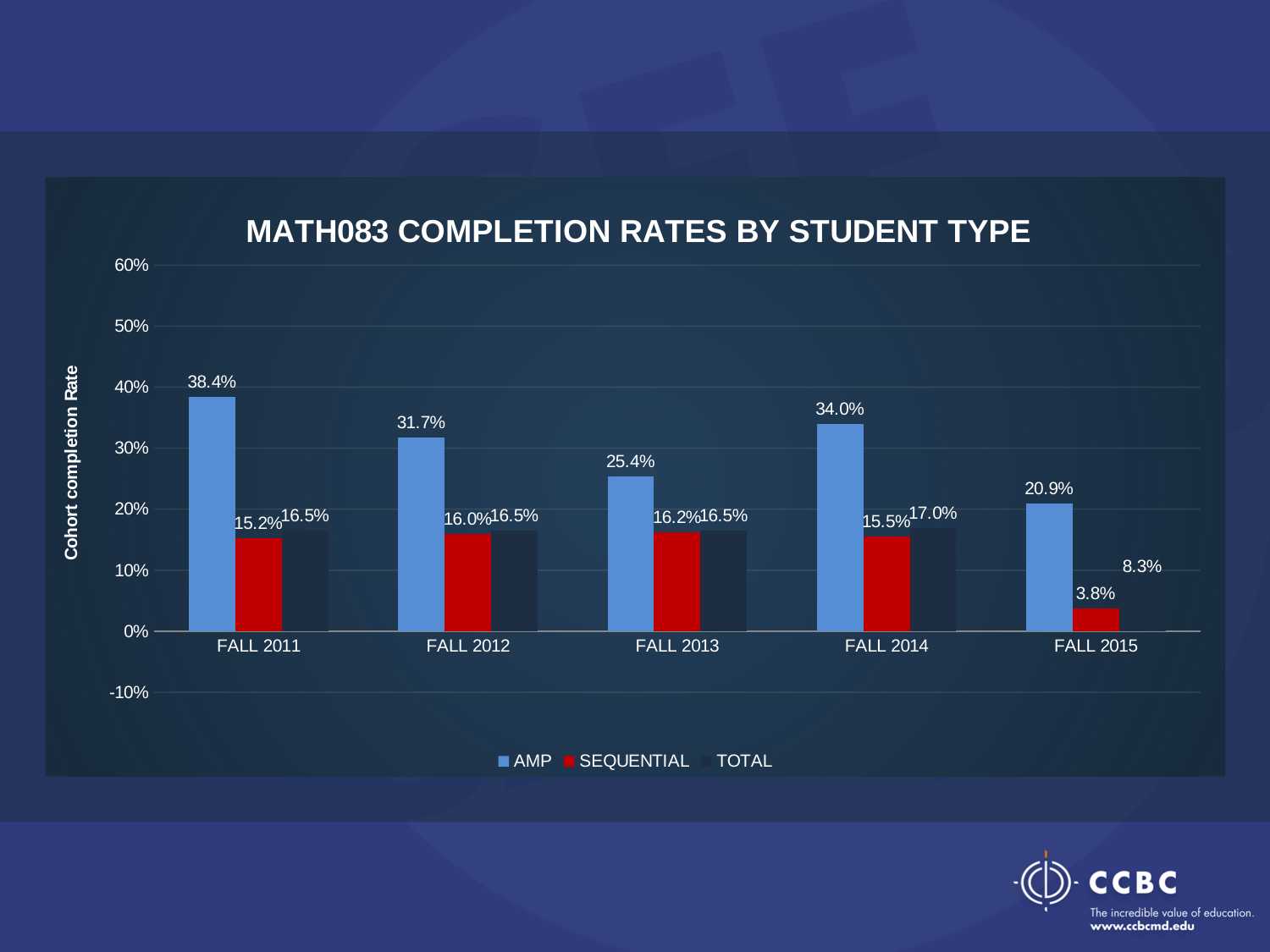
Which semester has the lowest SEQUENTIAL completion rate? FALL 2015 What is the title of the chart? MATH083 COMPLETION RATES BY STUDENT TYPE What is the SEQUENTIAL completion rate for FALL 2015? 3.8% How many series does the legend list? 3 What is the TOTAL completion rate for FALL 2014? 17.0% Which is larger, the AMP completion rate for FALL 2012 or for FALL 2013? FALL 2012 Which semester has the highest AMP completion rate? FALL 2011 What is the AMP completion rate for FALL 2011? 38.4% How many semesters are shown on the x axis? 5 What kind of chart is shown on the slide? Bar chart What is the difference between the AMP and SEQUENTIAL completion rates for FALL 2014? 18.5% Does the AMP completion rate rise or fall from FALL 2014 to FALL 2015? Fall